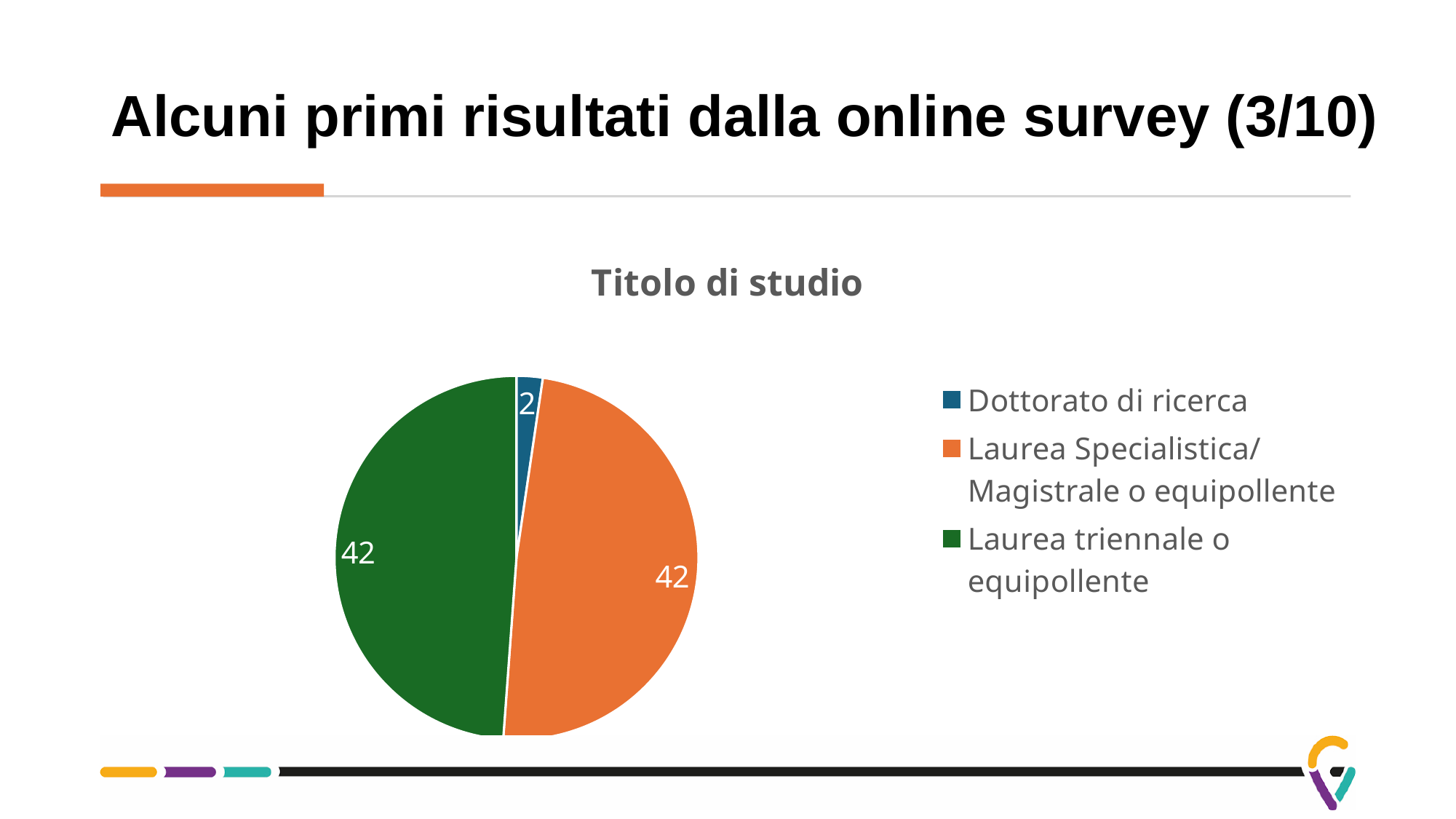
What is the value for Dottorato di ricerca in the pie chart? 2 Which colour represents Laurea triennale o equipollente in the pie chart? Green What is the difference between the values for Laurea triennale o equipollente and Dottorato di ricerca? 40 How many categories are shown in the pie chart? 3 What is the value for Laurea triennale o equipollente in the pie chart? 42 What is the value for Laurea Specialistica/Magistrale o equipollente in the pie chart? 42 What is the title of the chart? Titolo di studio How many entries does the legend list? 3 Which category has the smallest slice in the pie chart? Dottorato di ricerca What kind of chart is shown on the slide? Pie chart What is the total of all the values shown in the pie chart? 86 Which is larger: the value for Laurea Specialistica/Magistrale o equipollente or the value for Dottorato di ricerca? Laurea Specialistica/Magistrale o equipollente